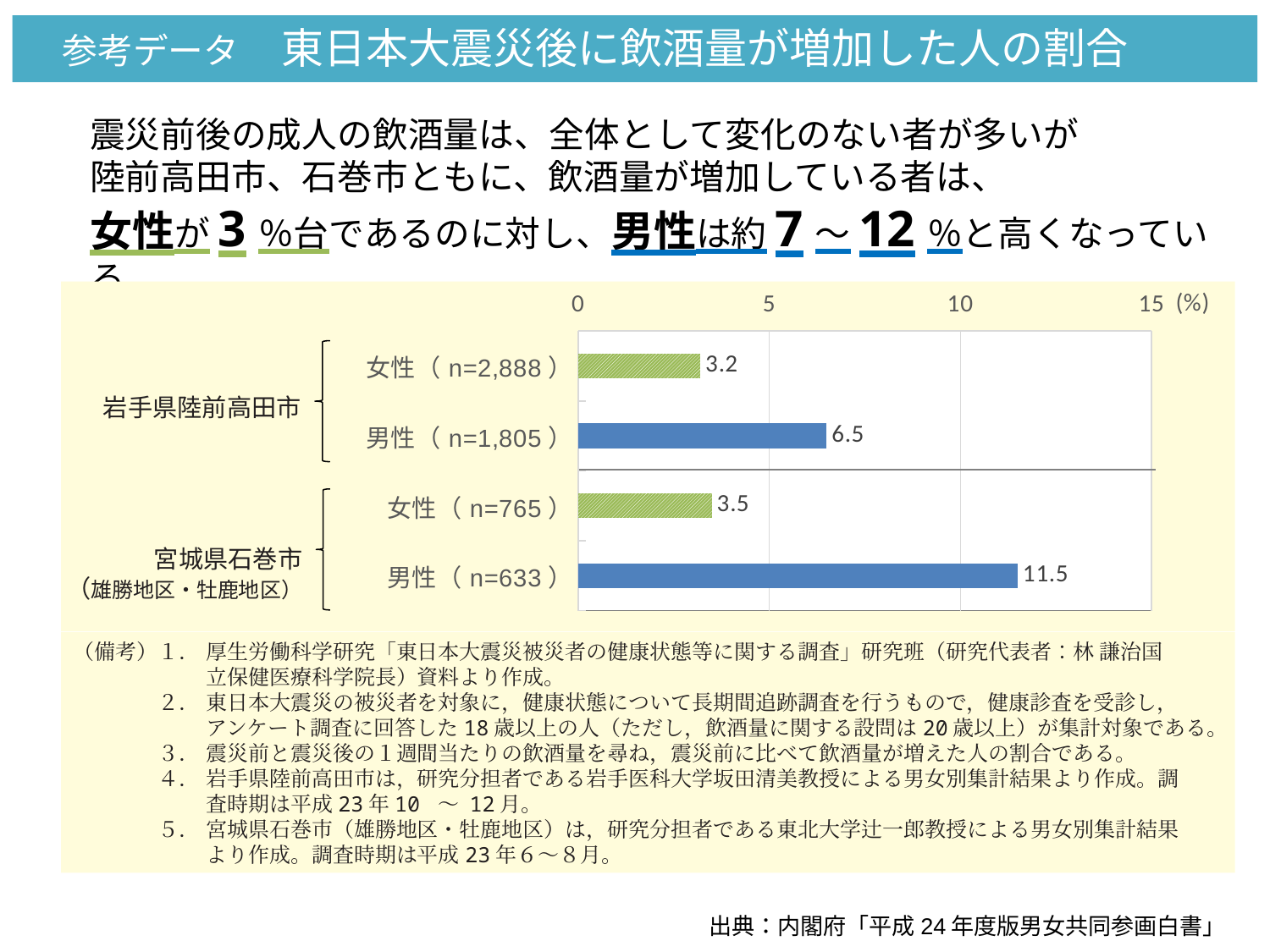
What is the difference between the 男性 and 女性 values in 宮城県石巻市? 8.0 Which is larger, the 男性 value in 岩手県陸前高田市 or the 男性 value in 宮城県石巻市? 宮城県石巻市 What is the difference between the 男性 and 女性 values in 岩手県陸前高田市? 3.3 How many bars are plotted in the chart? 4 What is the value for 男性 (n=1,805) in 岩手県陸前高田市? 6.5 What is the value for 男性 (n=633) in 宮城県石巻市? 11.5 What is the value for 女性 (n=2,888) in 岩手県陸前高田市? 3.2 Which bar has the highest value? 男性 (n=633) in 宮城県石巻市 Is the value for 男性 (n=633) in 宮城県石巻市 greater or less than 10? greater What is the value for 女性 (n=765) in 宮城県石巻市? 3.5 Which bar has the lowest value? 女性 (n=2,888) in 岩手県陸前高田市 What kind of chart is shown on the slide? bar chart